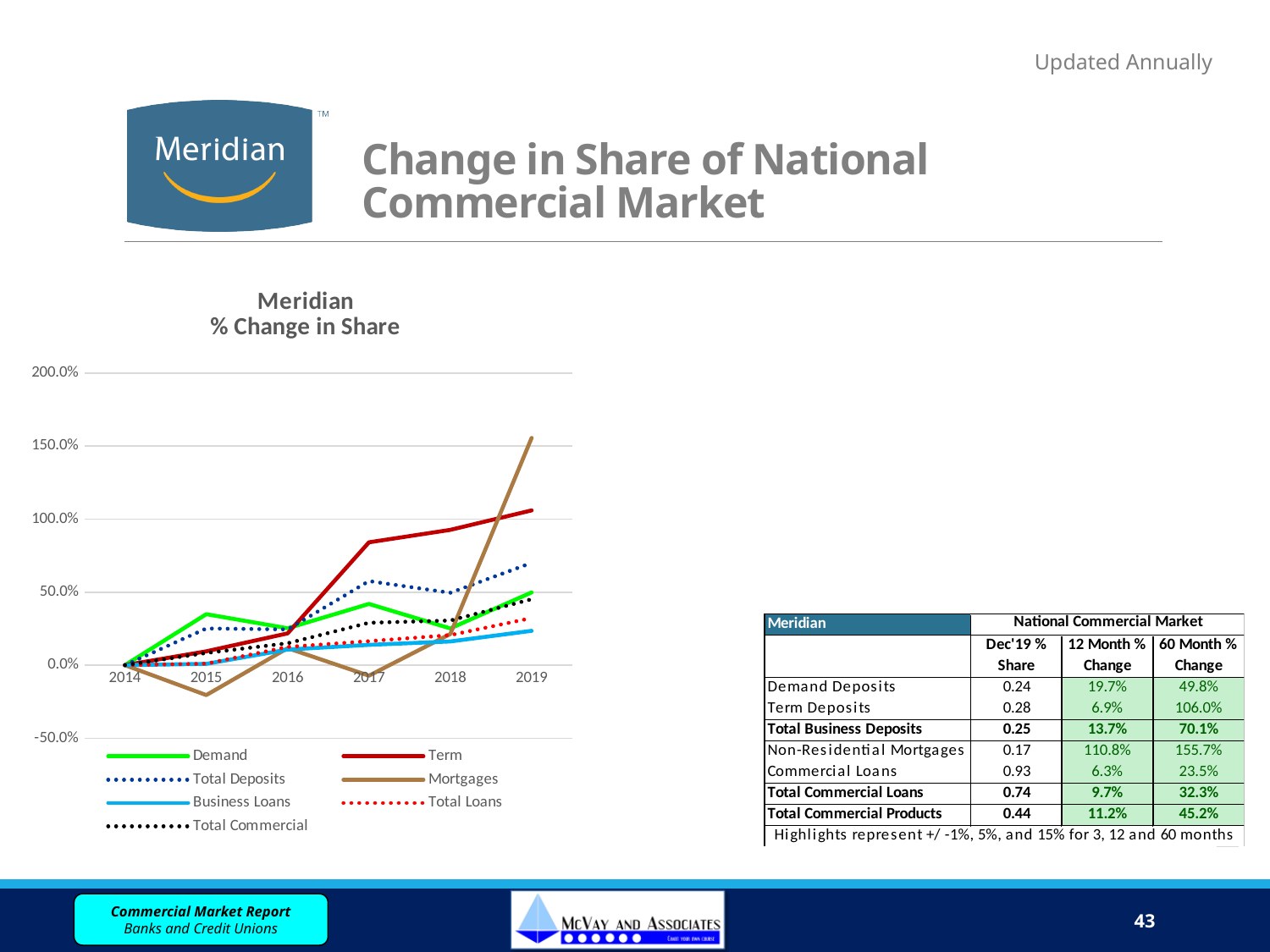
Which series has the lowest value in 2015? Mortgages How many series does the legend of the chart list? 7 How many years are shown along the x axis of the chart? 6 Is the value for Mortgages in 2015 greater or less than 0.0%? less What is the title of the chart? Meridian % Change in Share Which series has the highest value in 2019? Mortgages Does the Term series generally rise or fall from 2014 to 2019? rise Is the value for Business Loans in 2019 greater or less than 50.0%? less Is the value for Mortgages in 2019 greater or less than 100.0%? greater In 2019, which is larger: the value for Term or the value for Demand? Term What kind of chart is shown on the slide? line chart